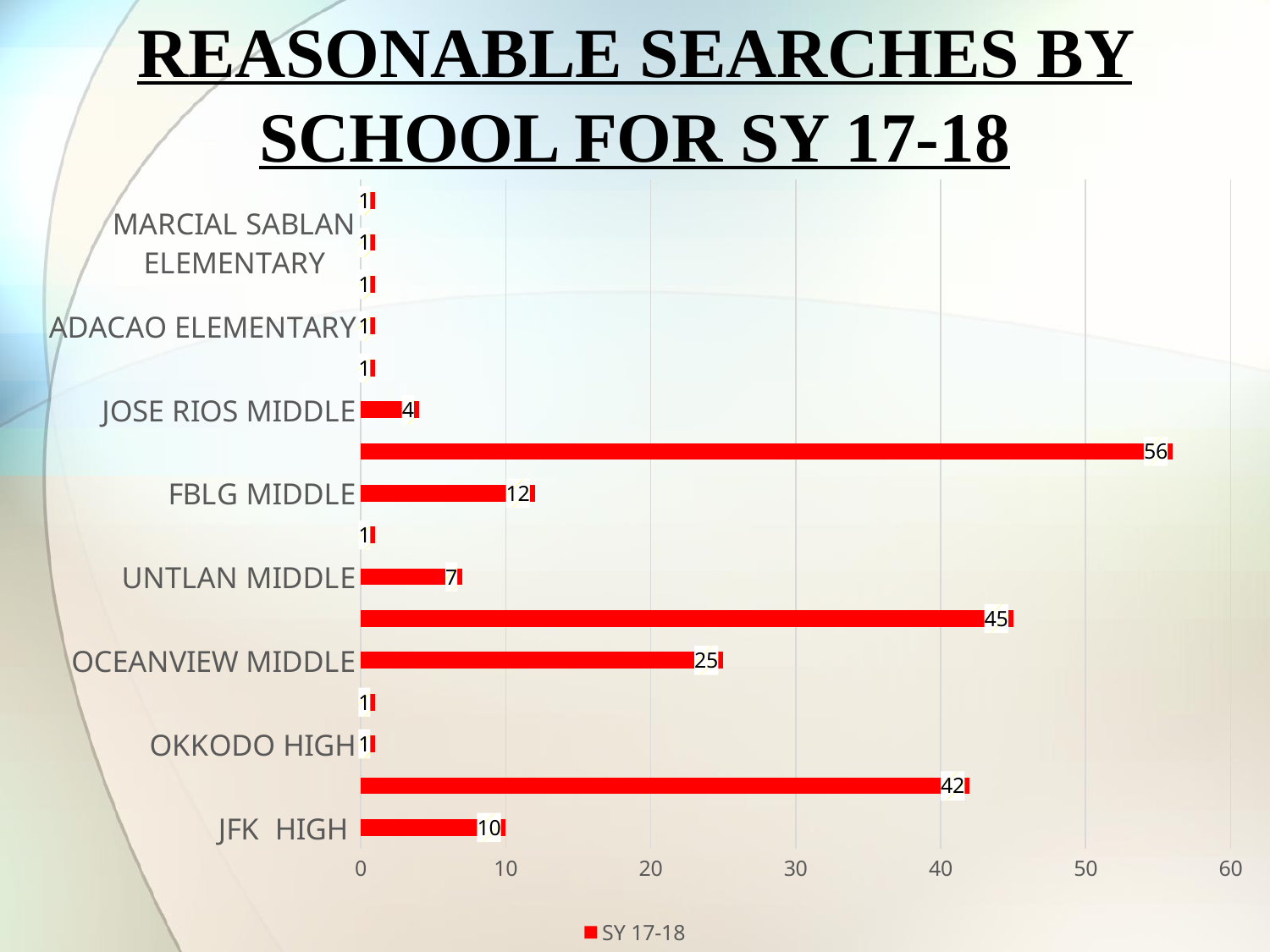
What is the value for OCEANVIEW MIDDLE? 25 How many bars are plotted in the chart? 16 What is the difference between the values for OCEANVIEW MIDDLE and FBLG MIDDLE? 13 Which has a larger value, FBLG MIDDLE or JFK HIGH? FBLG MIDDLE What is the value for FBLG MIDDLE? 12 What is the value for UNTLAN MIDDLE? 7 What is the value for OKKODO HIGH? 1 What is the value for JOSE RIOS MIDDLE? 4 What kind of chart is shown on the slide? bar chart What is the value for JFK HIGH? 10 What is the largest value shown on any bar in the chart? 56 Is the value for OCEANVIEW MIDDLE greater or less than 20? greater